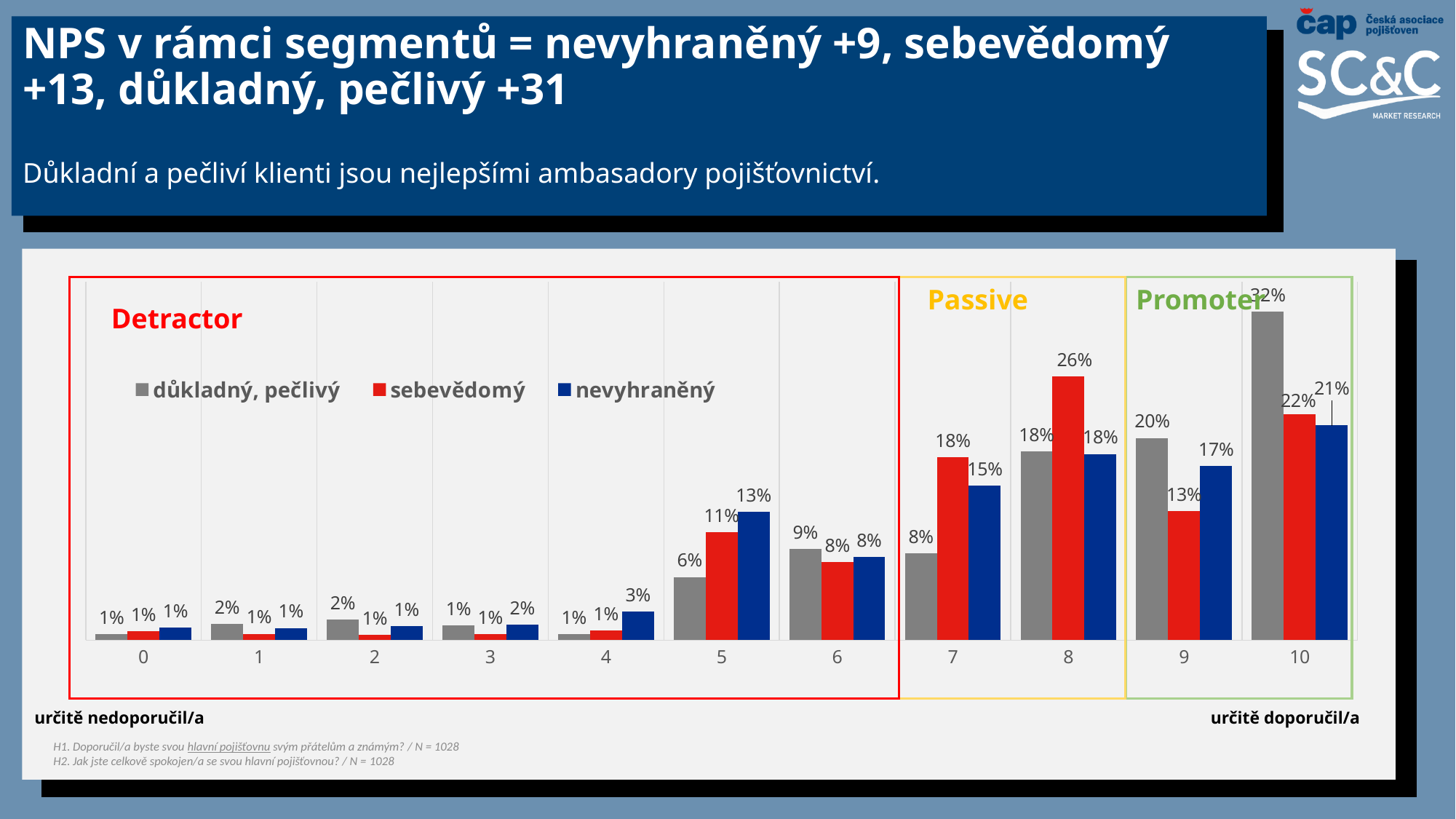
What is the value for the 'sebevědomý' series at category 8? 26% Which series is shown in red in the legend? sebevědomý How many categories are shown on the x axis? 11 Which category has the highest value for the 'sebevědomý' series? 8 What is the value for the 'důkladný, pečlivý' series at category 10? 32% What is the value for the 'důkladný, pečlivý' series at category 9? 20% At category 9, which series has the larger value: 'sebevědomý' or 'nevyhraněný'? nevyhraněný What is the difference between the 'sebevědomý' and 'důkladný, pečlivý' values at category 7? 10% What is the value for the 'nevyhraněný' series at category 5? 13% How many series does the legend list? 3 Which category has the highest value for the 'důkladný, pečlivý' series? 10 What kind of chart is shown on the slide? bar chart